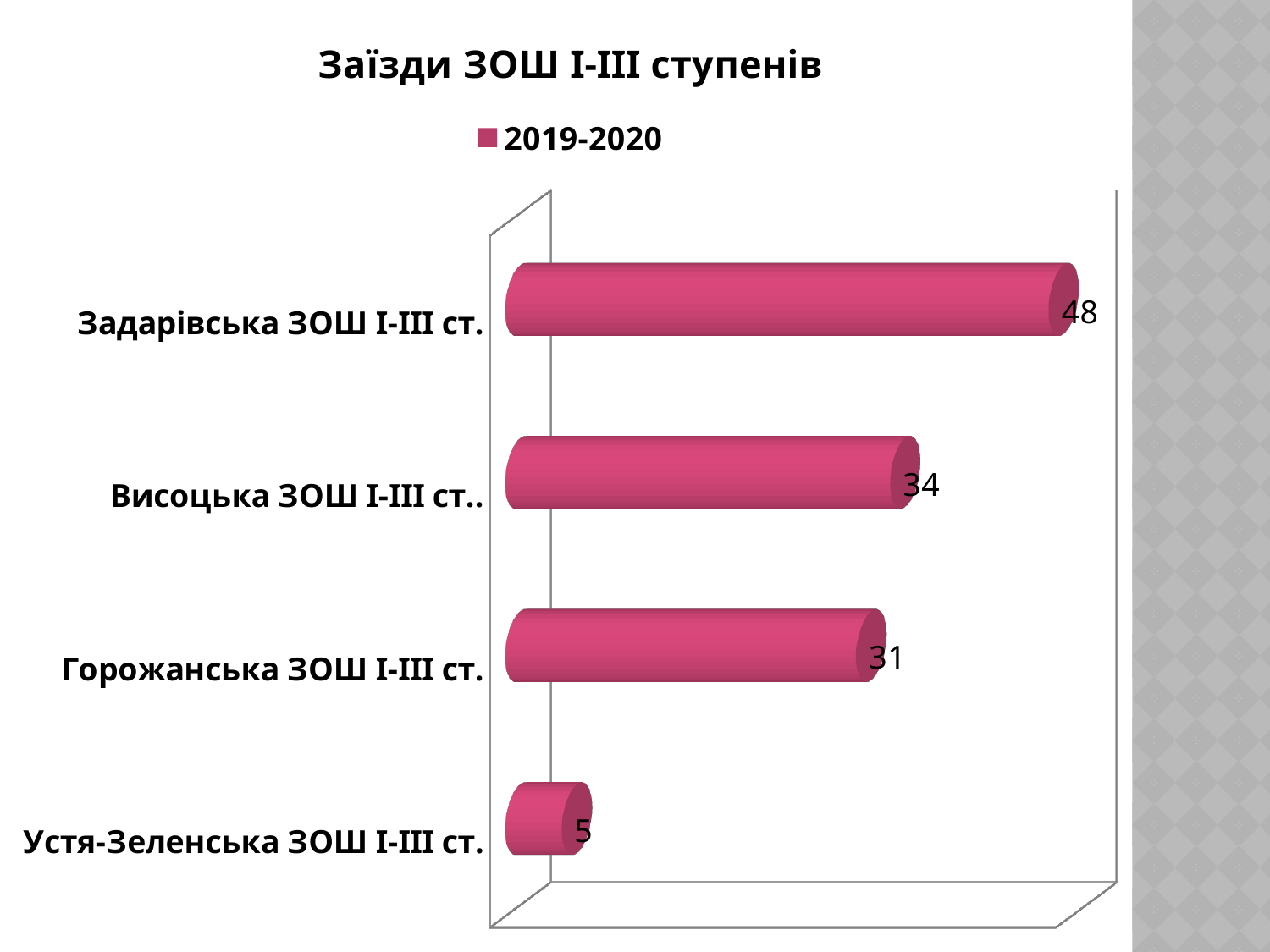
Which school has the highest value? Задарівська ЗОШ І-ІІІ ст. What is the difference between the values for Висоцька ЗОШ І-ІІІ ст.. and Горожанська ЗОШ І-ІІІ ст.? 3 How many schools are shown in the chart? 4 What is the value for Задарівська ЗОШ І-ІІІ ст.? 48 What is the value for Горожанська ЗОШ І-ІІІ ст.? 31 What kind of chart is shown on the slide? bar chart Which is larger, the value for Горожанська ЗОШ І-ІІІ ст. or Устя-Зеленська ЗОШ І-ІІІ ст.? Горожанська ЗОШ І-ІІІ ст. Which school has the lowest value? Устя-Зеленська ЗОШ І-ІІІ ст. How many series does the legend list? 1 What is the difference between the values for Задарівська ЗОШ І-ІІІ ст. and Устя-Зеленська ЗОШ І-ІІІ ст.? 43 What is the value for Висоцька ЗОШ І-ІІІ ст..? 34 What is the value for Устя-Зеленська ЗОШ І-ІІІ ст.? 5